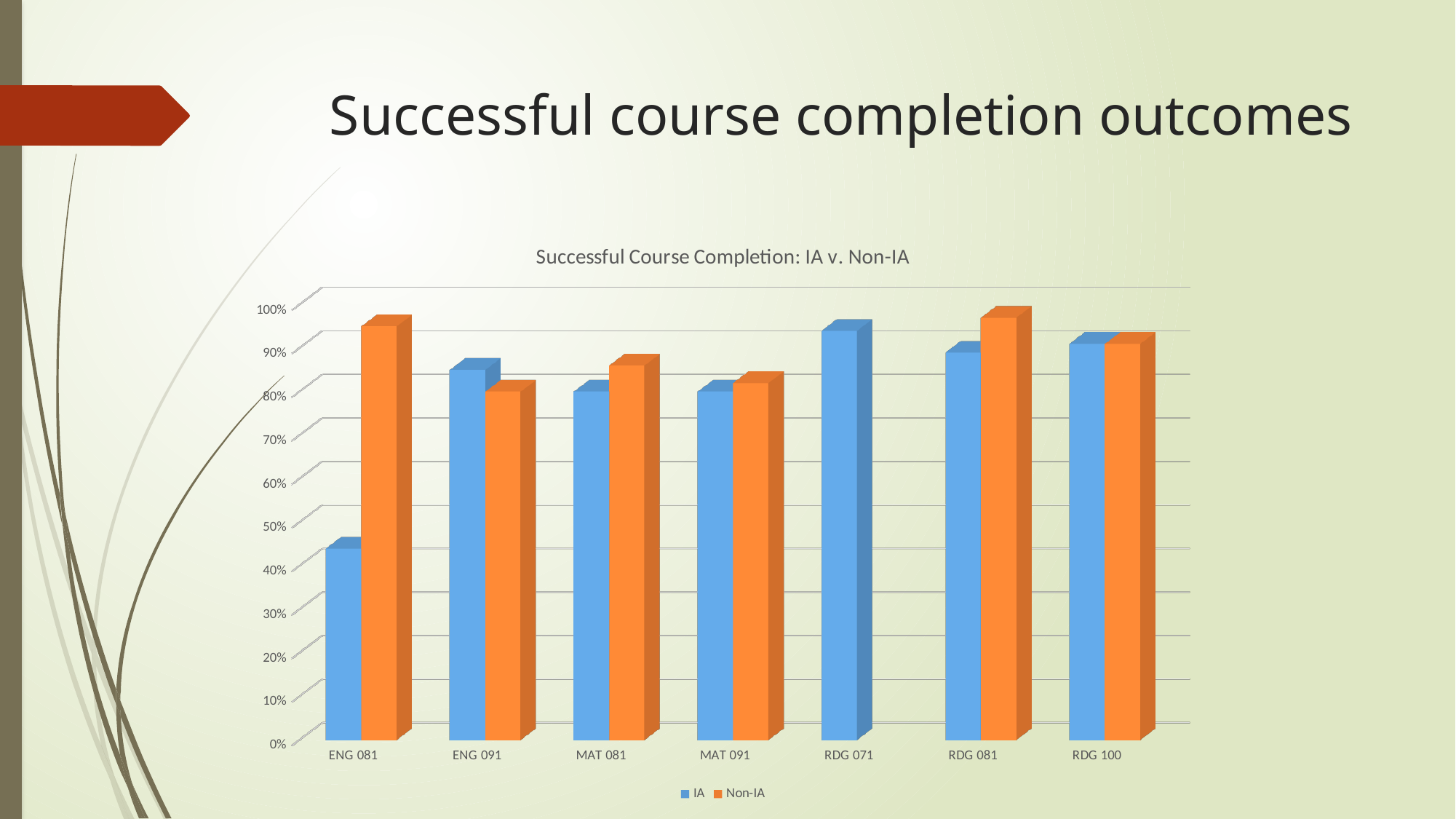
Which course has the highest IA completion rate? RDG 071 How many course categories are shown on the x axis? 7 For ENG 081, which is larger, the IA or the Non-IA completion rate? Non-IA Is the IA value for RDG 071 greater or less than 90%? greater Is the IA value for ENG 081 greater or less than 50%? less For ENG 091, which is larger, the IA or the Non-IA completion rate? IA Which series is shown in orange? Non-IA What kind of chart is shown on the slide? bar chart Is the Non-IA value for ENG 081 greater or less than 90%? greater Which course has the lowest IA completion rate? ENG 081 How many series does the legend list? 2 What is the title of the chart? Successful Course Completion: IA v. Non-IA